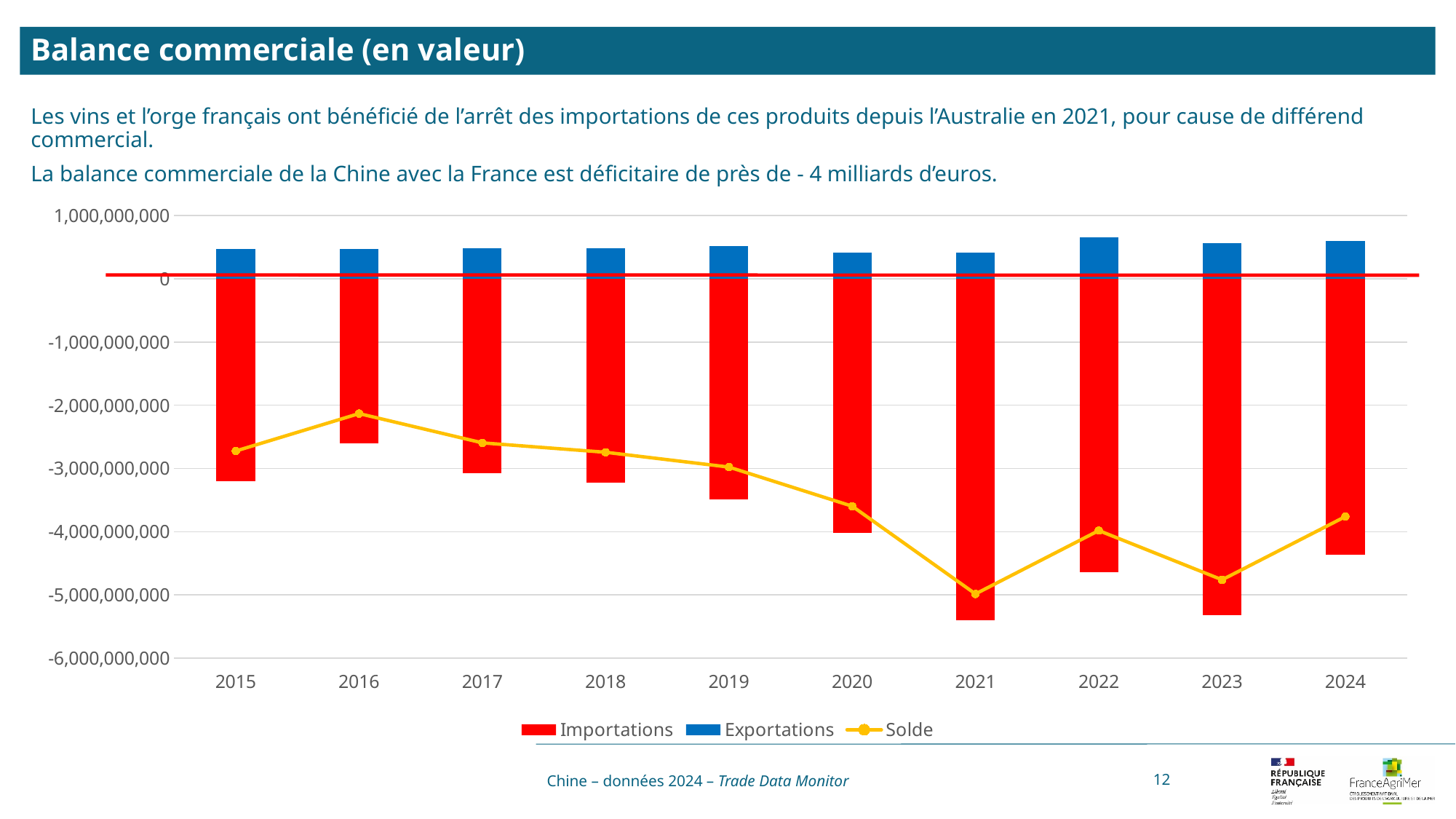
Is the Importations value for 2021 greater or less than -5,000,000,000? less In which year is the Importations bar the most negative (longest)? 2021 Is the Solde value for 2016 greater or less than -3,000,000,000? greater Which series is drawn as a yellow line in the chart? Solde In which year does the Solde line reach its lowest point? 2021 In which year is the Importations bar the least negative (shortest)? 2016 How many series does the chart legend list? 3 What is the title of the slide containing the chart? Balance commerciale (en valeur) How many years are shown on the x axis of the chart? 10 In which year does the Solde line reach its highest point? 2016 Is the Solde value for 2023 greater or less than -4,000,000,000? less What kind of chart is shown on the slide? Combined bar and line chart